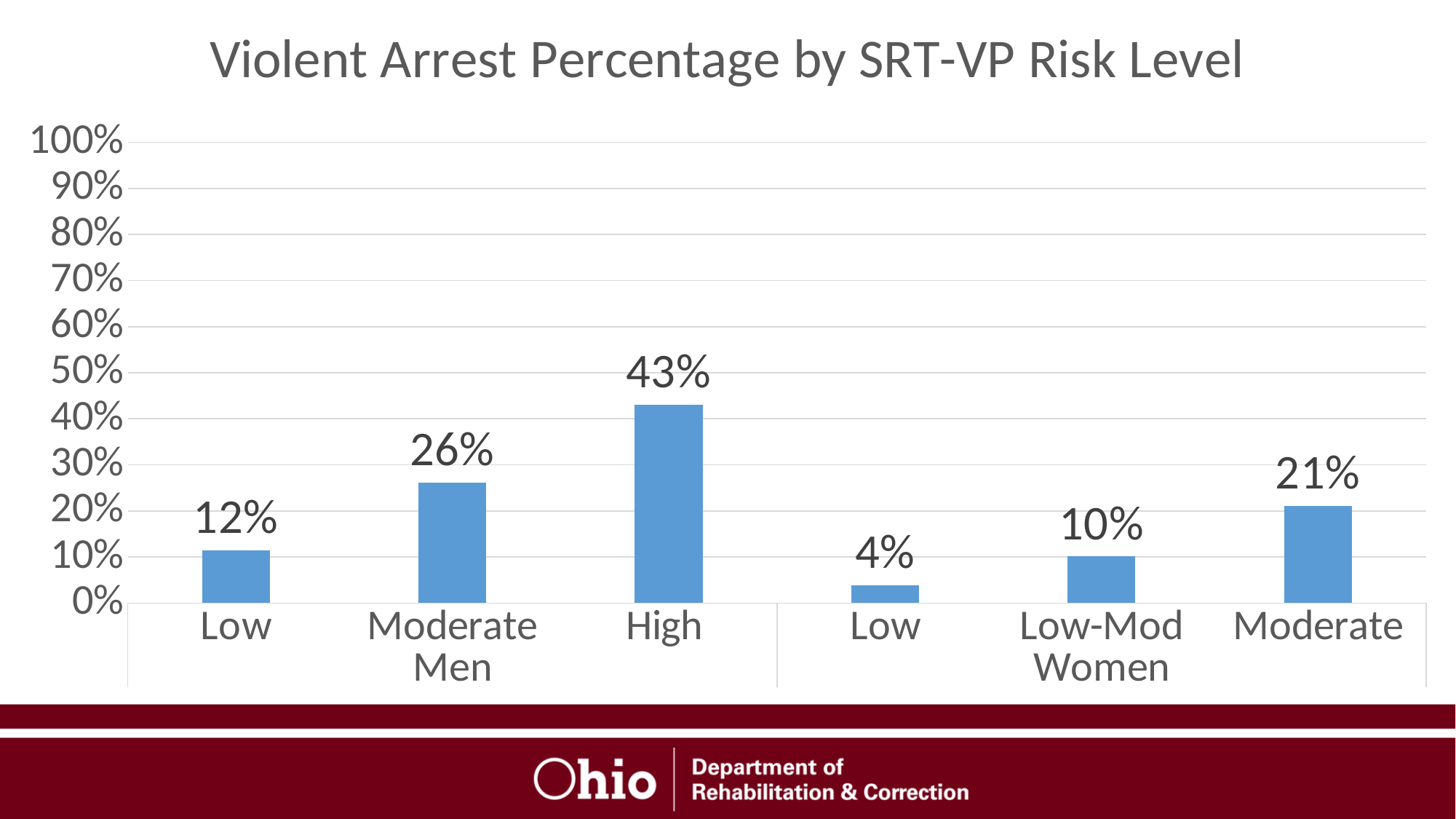
Is the violent arrest percentage for High risk men greater or less than 50%? less What is the violent arrest percentage for Low-Mod risk women? 10% What is the difference between the violent arrest percentage for High risk men and Moderate risk men? 17% How many bars are shown in the chart? 6 Which group has the highest violent arrest percentage? High (Men) What type of chart is shown on the slide? Bar chart Which group has the lowest violent arrest percentage? Low (Women) What is the violent arrest percentage for Moderate risk men? 26% Which is larger, the violent arrest percentage for Low risk men or Low-Mod risk women? Low risk men What is the violent arrest percentage for Low risk women? 4% What is the difference between the violent arrest percentage for Moderate risk women and Low risk women? 17% What is the violent arrest percentage for High risk men? 43%